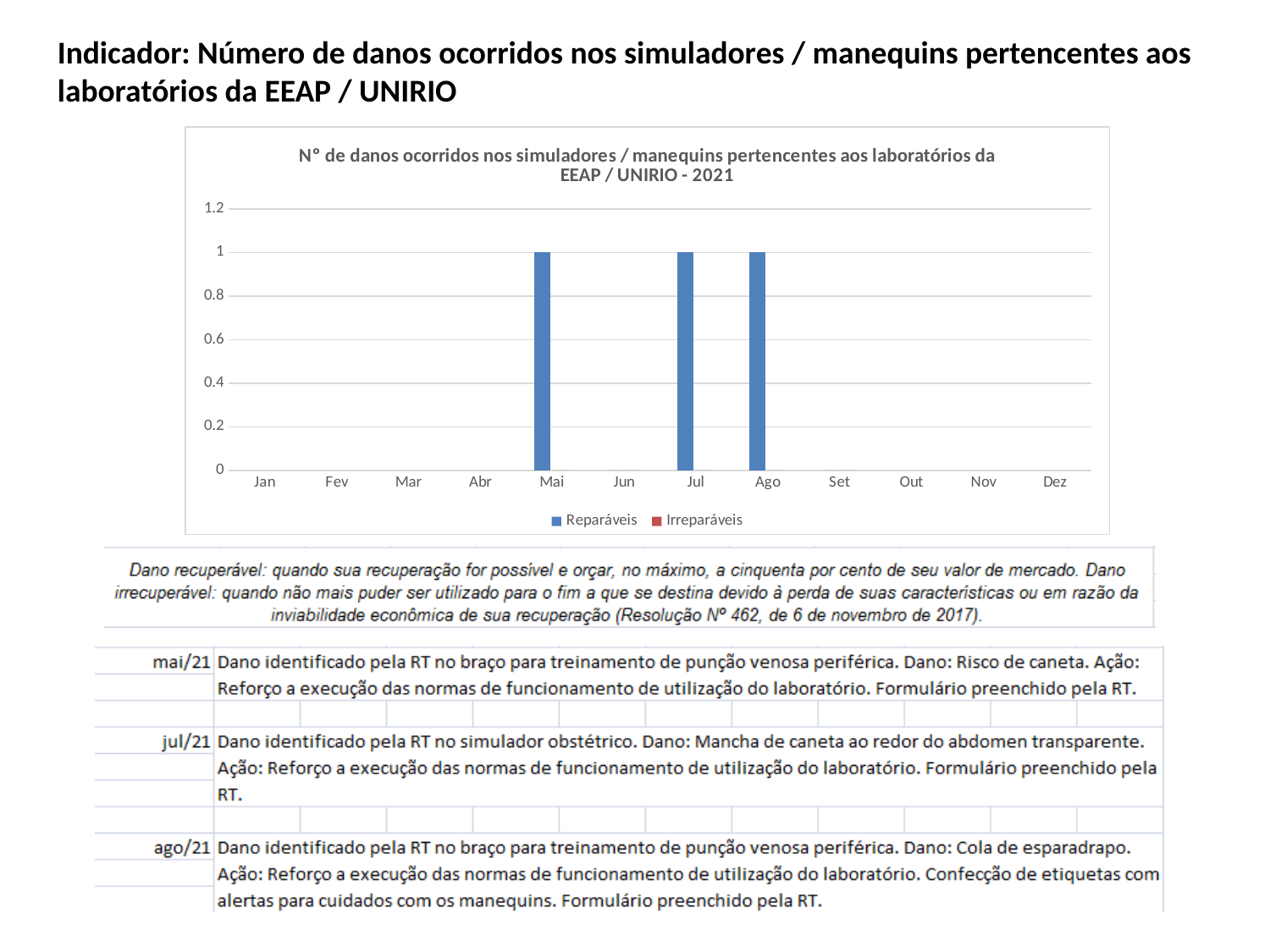
How many months are shown along the x axis of the chart? 12 What is the value of Reparáveis for Ago? 1 What is the highest value shown on the chart's y axis? 1.2 What kind of chart is shown on the slide? bar chart In which months does the chart show a bar for Reparáveis? Mai, Jul and Ago What is the value of Reparáveis for Jul? 1 What are the two series named in the chart legend? Reparáveis and Irreparáveis Is the value for Reparáveis in Jun greater or less than 0.2? less What is the value of Reparáveis for Mai? 1 Is the value for Reparáveis in Mai greater or less than 0.8? greater Which is larger, the Reparáveis value for Mai or for Jun? Mai How many series does the chart legend list? 2